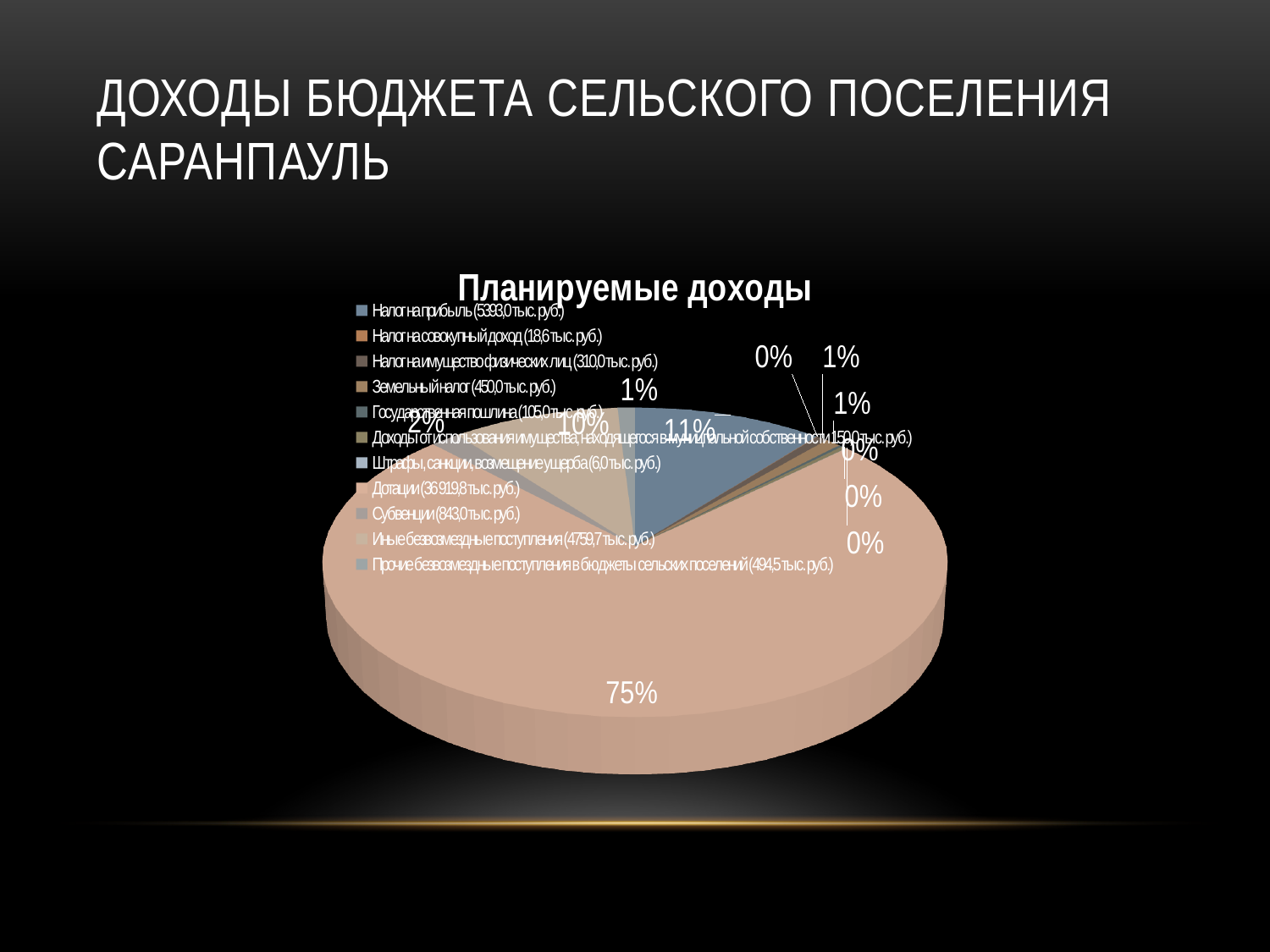
Which is larger on the pie chart: the slice labelled 11% or the slice labelled 10%? the slice labelled 11% How many slices of the pie chart are labelled 0%? 4 Is the largest slice of the pie chart greater or less than 50%? greater What is the second-largest percentage labelled on the pie chart? 11% What kind of chart is shown on the slide? pie chart What is the largest percentage shown as a data label on the pie chart? 75% What is the title of the chart on the slide? Планируемые доходы How many entries does the legend of the pie chart list? 11 What is the smallest percentage value labelled on the pie chart? 0% According to the legend, what amount is given for Дотации? 36 919,8 тыс. руб. What is the difference between the 75% slice and the 11% slice on the pie chart? 64% How many slices of the pie chart are labelled 1%? 3